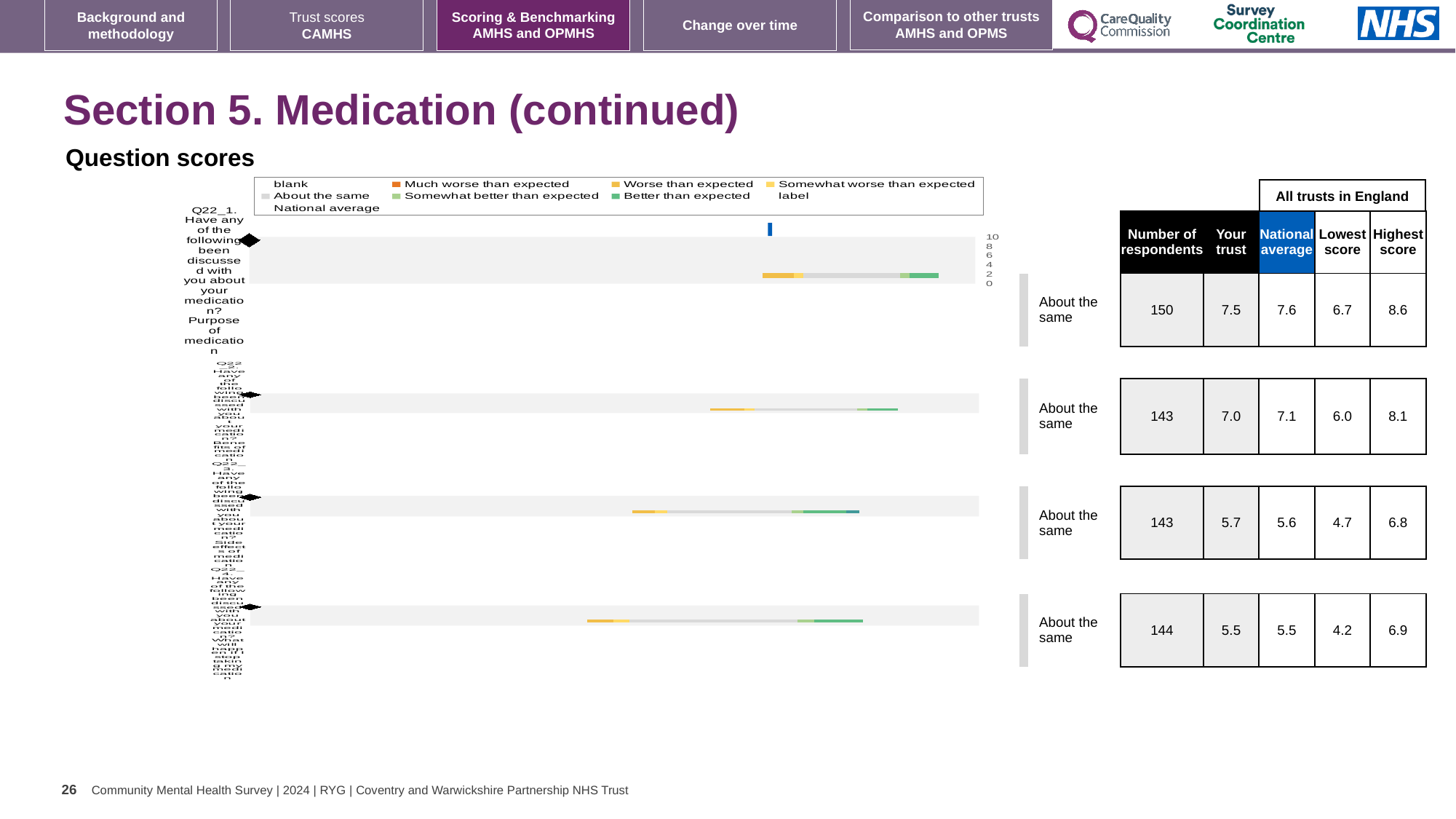
In the table beside the chart, what is the 'Your trust' score for Q22_1 (Purpose of medication)? 7.5 How many question bars are plotted in the chart? 4 What benchmark rating is shown next to each of the four question bars? About the same In the table beside the chart, what is the highest score for Q22_4 (What will happen if I stop taking my medication)? 6.9 In the table beside the chart, what is the national average for Q22_3 (Side effects of medication)? 5.6 In the chart legend, what colour represents 'About the same'? grey What kind of chart is used to show the question scores on this slide? bar chart For Q22_2 (Benefits of medication), what is the difference between the highest score and the lowest score in the table? 2.1 Which question has the highest 'Your trust' score in the table beside the chart? Q22_1 (Purpose of medication) For Q22_3 (Side effects of medication), which is larger: the 'Your trust' score or the national average? Your trust In the table beside the chart, how many respondents are listed for Q22_1 (Purpose of medication)? 150 What is the highest tick value shown on the chart's axis? 10